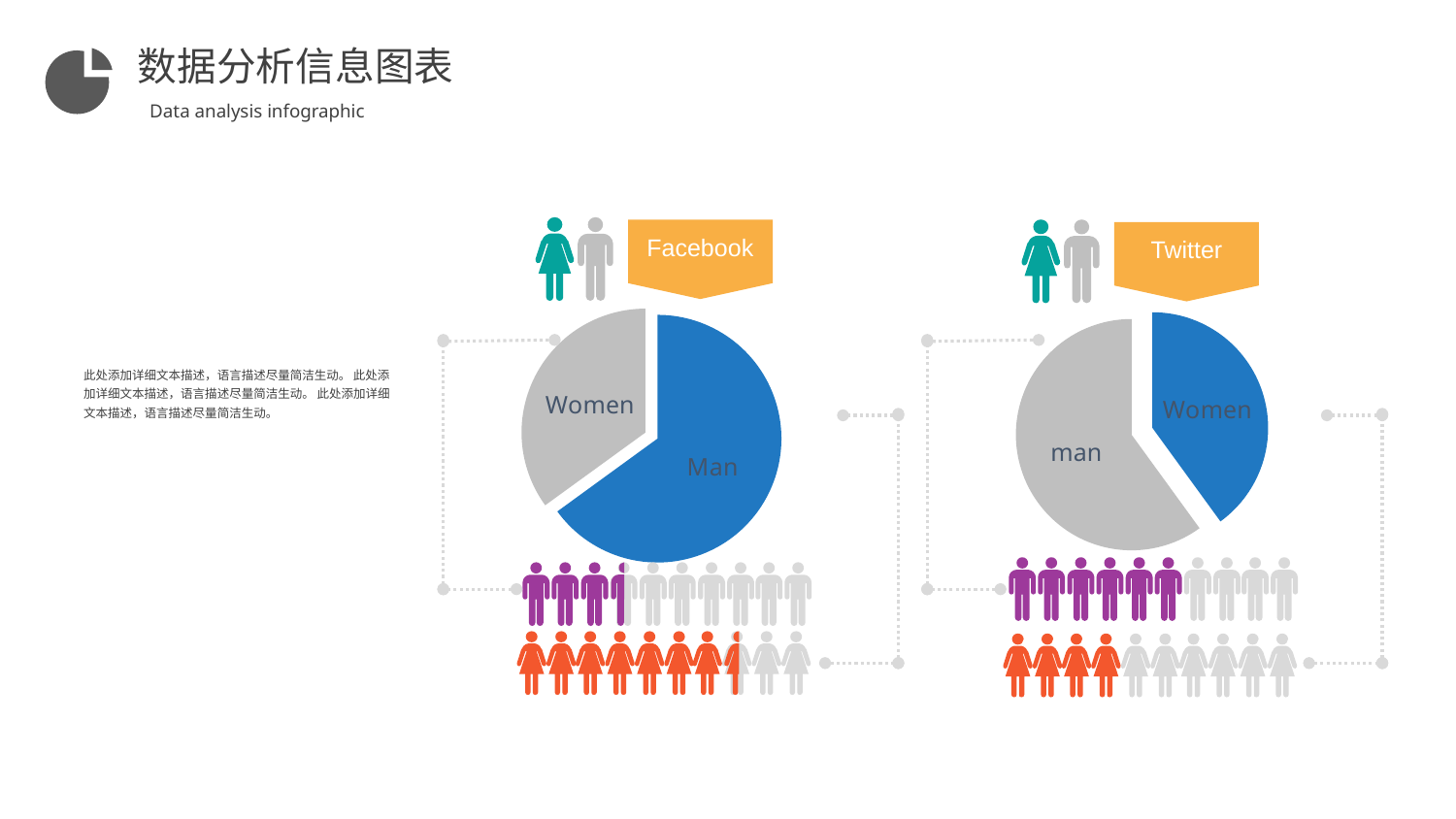
In the Facebook pie chart, which slice is the smallest? Women In the Twitter pie chart, which slice is the smallest? Women In the Twitter pie chart, is the Women slice or the man slice larger? man In the Facebook pie chart, which slice is the largest? Man What kind of chart is the Facebook chart? pie chart What kind of chart is the Twitter chart? pie chart How many slices does the Facebook pie chart have? 2 In the Facebook pie chart, is the Women slice or the Man slice larger? Man How many slices does the Twitter pie chart have? 2 What label appears in the orange banner above the right-hand pie chart? Twitter In the Twitter pie chart, which slice is the largest? man What colour is the Man slice in the Facebook pie chart? blue